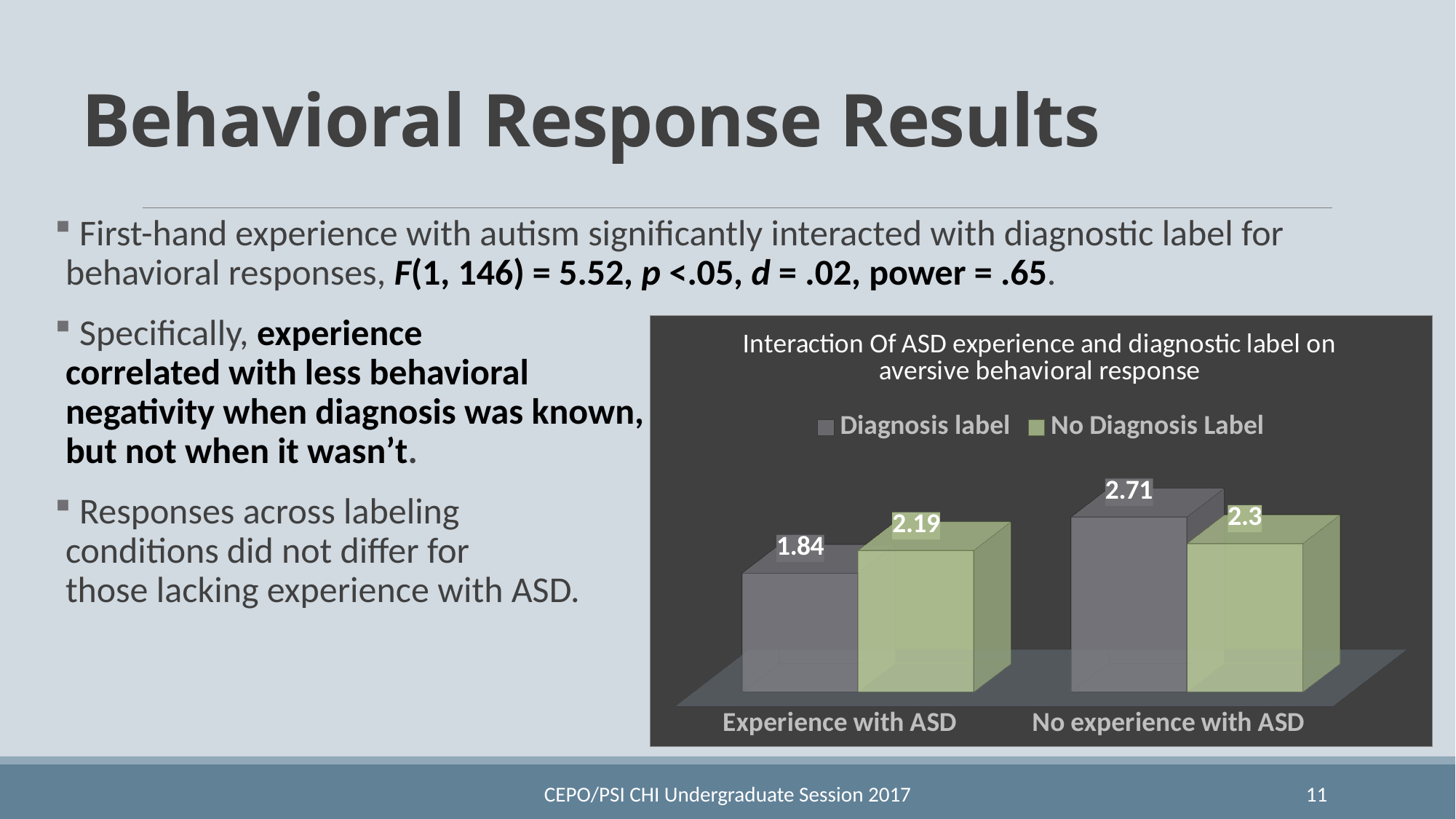
In the No experience with ASD category, which series has the larger value, Diagnosis label or No Diagnosis Label? Diagnosis label Which category has the highest Diagnosis label value? No experience with ASD How many categories are shown on the x axis of the chart? 2 Which bar has the lowest value in the chart? Diagnosis label, Experience with ASD What type of chart is shown on the slide? Bar chart What is the value for Diagnosis label in the Experience with ASD category? 1.84 What is the difference between the Diagnosis label values for No experience with ASD and Experience with ASD? 0.87 How many series does the chart legend list? 2 What is the value for Diagnosis label in the No experience with ASD category? 2.71 What is the value for No Diagnosis Label in the No experience with ASD category? 2.3 What is the difference between the No Diagnosis Label and Diagnosis label values in the Experience with ASD category? 0.35 What is the value for No Diagnosis Label in the Experience with ASD category? 2.19